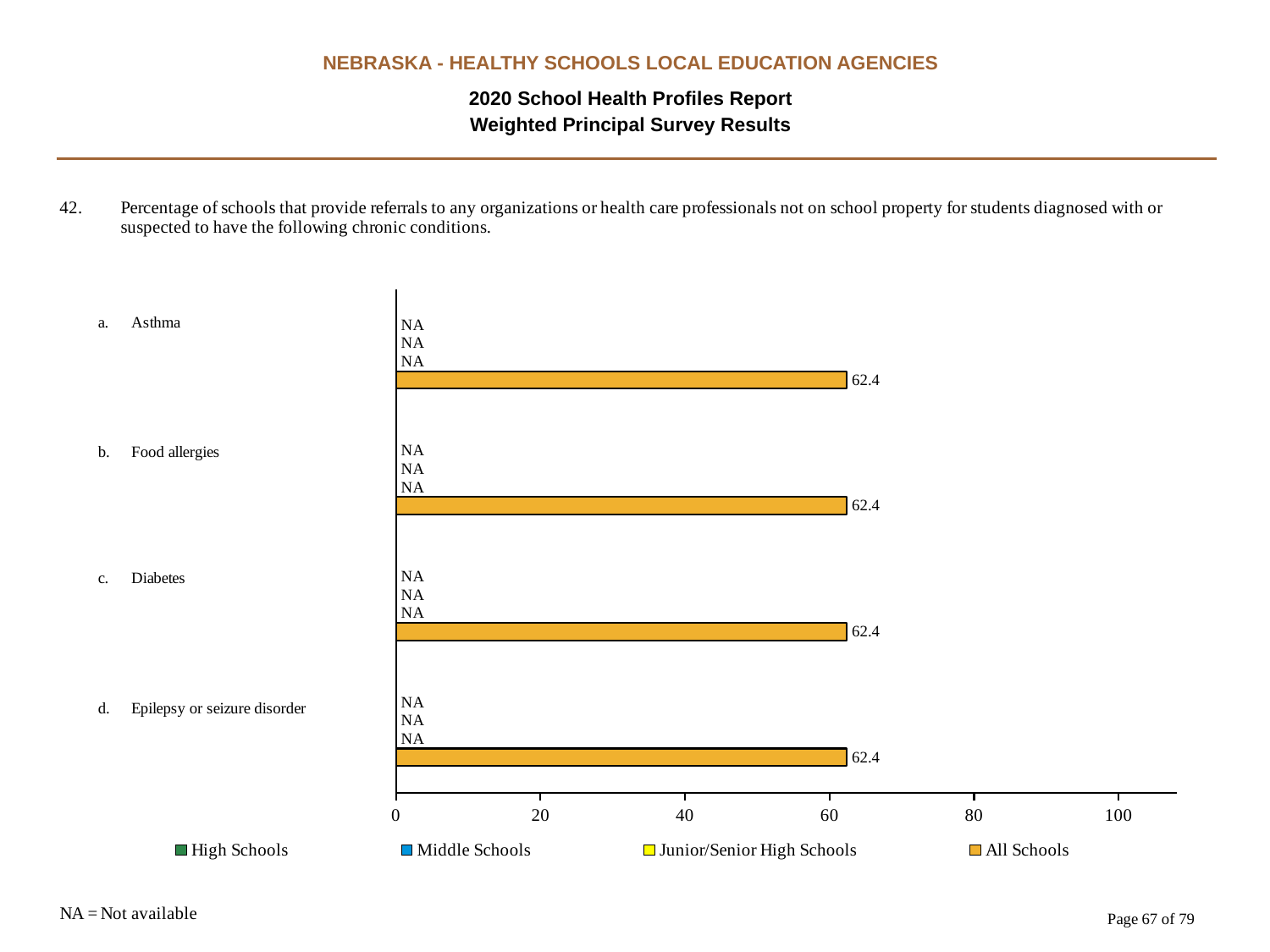
What kind of chart is shown on the slide? Bar chart What is shown for Middle Schools for Diabetes? NA What is the value for All Schools for Epilepsy or seizure disorder? 62.4 How many chronic conditions are listed on the chart? 4 How many series does the legend list? 4 What is the value for All Schools for Food allergies? 62.4 What is the difference between the All Schools values for Asthma and Diabetes? 0 What is shown for High Schools for Asthma? NA Is the All Schools value for Food allergies greater or less than 60? greater What is the value for All Schools for Asthma? 62.4 Is the All Schools value for Epilepsy or seizure disorder greater or less than 80? less What is the value for All Schools for Diabetes? 62.4